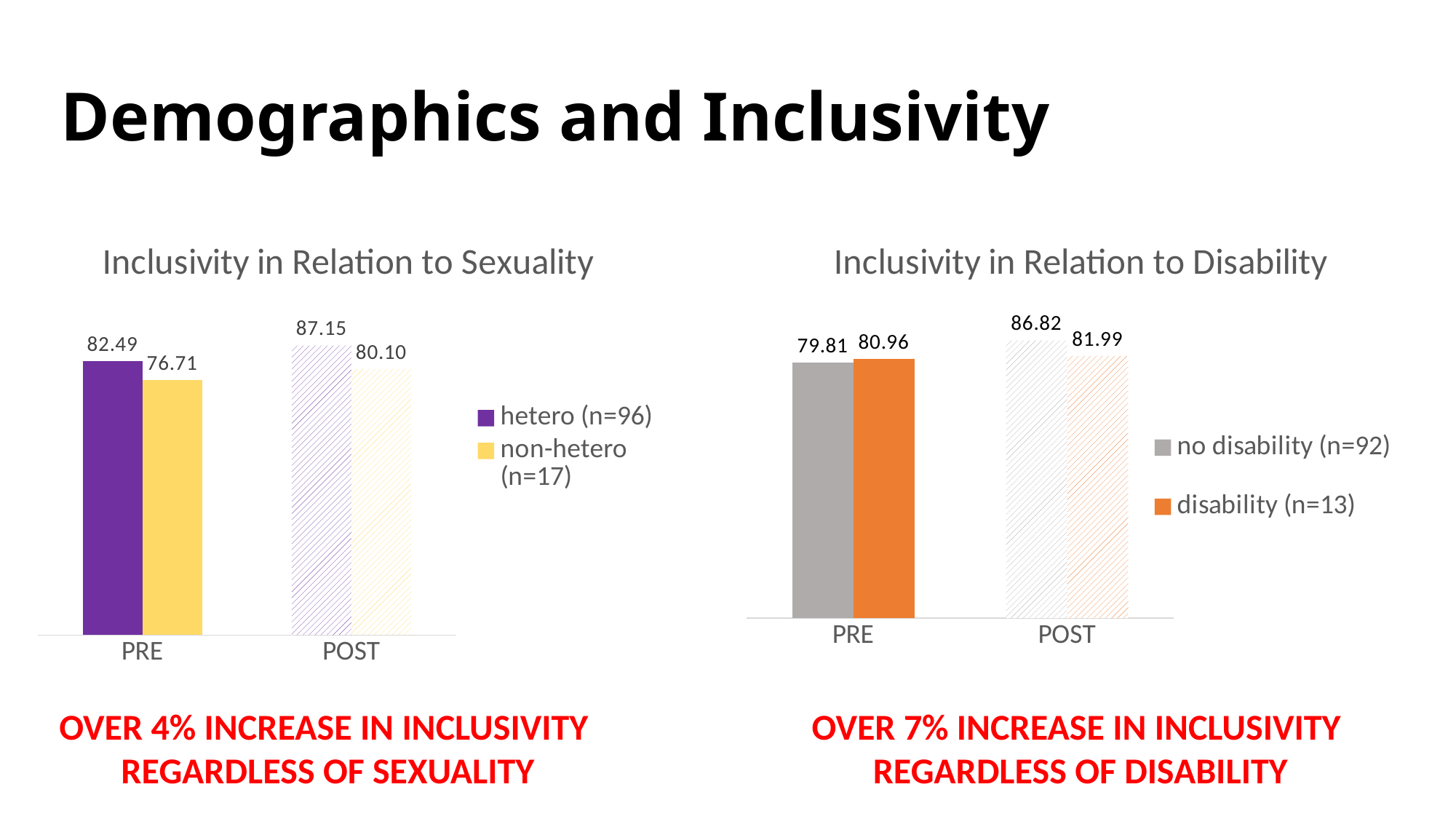
How many series does the legend of the 'Inclusivity in Relation to Disability' chart list? 2 In the 'Inclusivity in Relation to Disability' chart, do the values for disability (n=13) rise or fall from PRE to POST? rise In the 'Inclusivity in Relation to Sexuality' chart, which series has the highest value overall? hetero (n=96) In the 'Inclusivity in Relation to Sexuality' chart, by how much did the hetero (n=96) value increase from PRE to POST? 4.66 In the 'Inclusivity in Relation to Sexuality' chart, which bar has the lowest value? non-hetero (n=17) PRE What kind of chart is 'Inclusivity in Relation to Sexuality'? bar chart In the 'Inclusivity in Relation to Sexuality' chart, what is the POST value for non-hetero (n=17)? 80.10 In the 'Inclusivity in Relation to Sexuality' chart, what is the PRE value for hetero (n=96)? 82.49 In the 'Inclusivity in Relation to Disability' chart, which is larger at POST: no disability (n=92) or disability (n=13)? no disability (n=92) In the 'Inclusivity in Relation to Disability' chart, what is the POST value for no disability (n=92)? 86.82 In the 'Inclusivity in Relation to Disability' chart, what is the PRE value for disability (n=13)? 80.96 In the 'Inclusivity in Relation to Disability' chart, by how much did the no disability (n=92) value increase from PRE to POST? 7.01